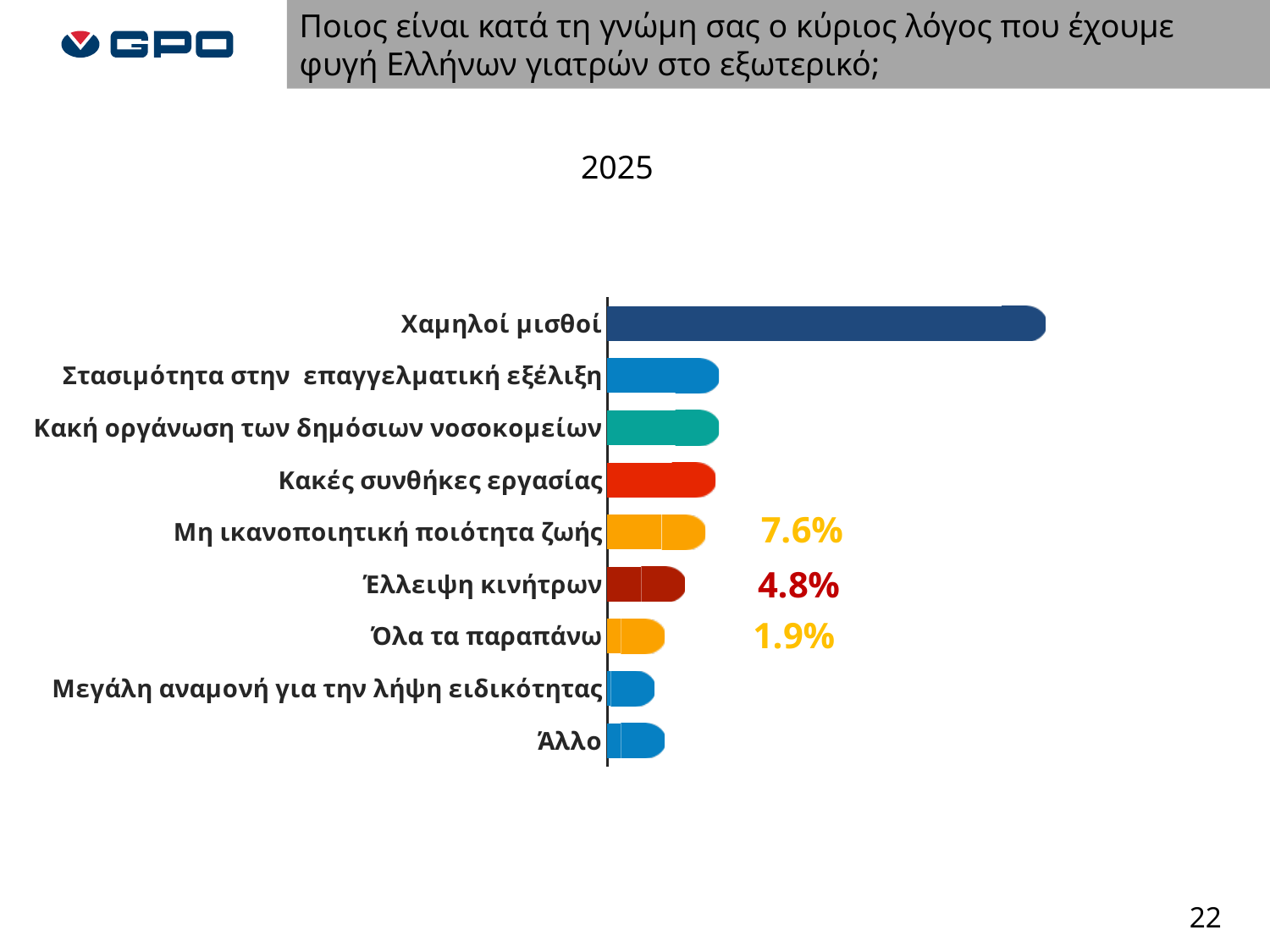
What is the difference between the labelled values for Μη ικανοποιητική ποιότητα ζωής and Έλλειψη κινήτρων? 2.8% Which is larger: the bar for Κακές συνθήκες εργασίας or the bar for Όλα τα παραπάνω? Κακές συνθήκες εργασίας Which is larger: the bar for Χαμηλοί μισθοί or the bar for Στασιμότητα στην επαγγελματική εξέλιξη? Χαμηλοί μισθοί How many categories are plotted in the chart? 9 What year is shown as the chart's title? 2025 Which is larger: the bar for Έλλειψη κινήτρων or the bar for Μεγάλη αναμονή για την λήψη ειδικότητας? Έλλειψη κινήτρων What value is labelled for Όλα τα παραπάνω? 1.9% Which category has the longest bar in the chart? Χαμηλοί μισθοί What value is labelled for Έλλειψη κινήτρων? 4.8% What kind of chart is shown on the slide? bar chart What value is labelled for Μη ικανοποιητική ποιότητα ζωής? 7.6% What colour is the bar for Χαμηλοί μισθοί? dark blue